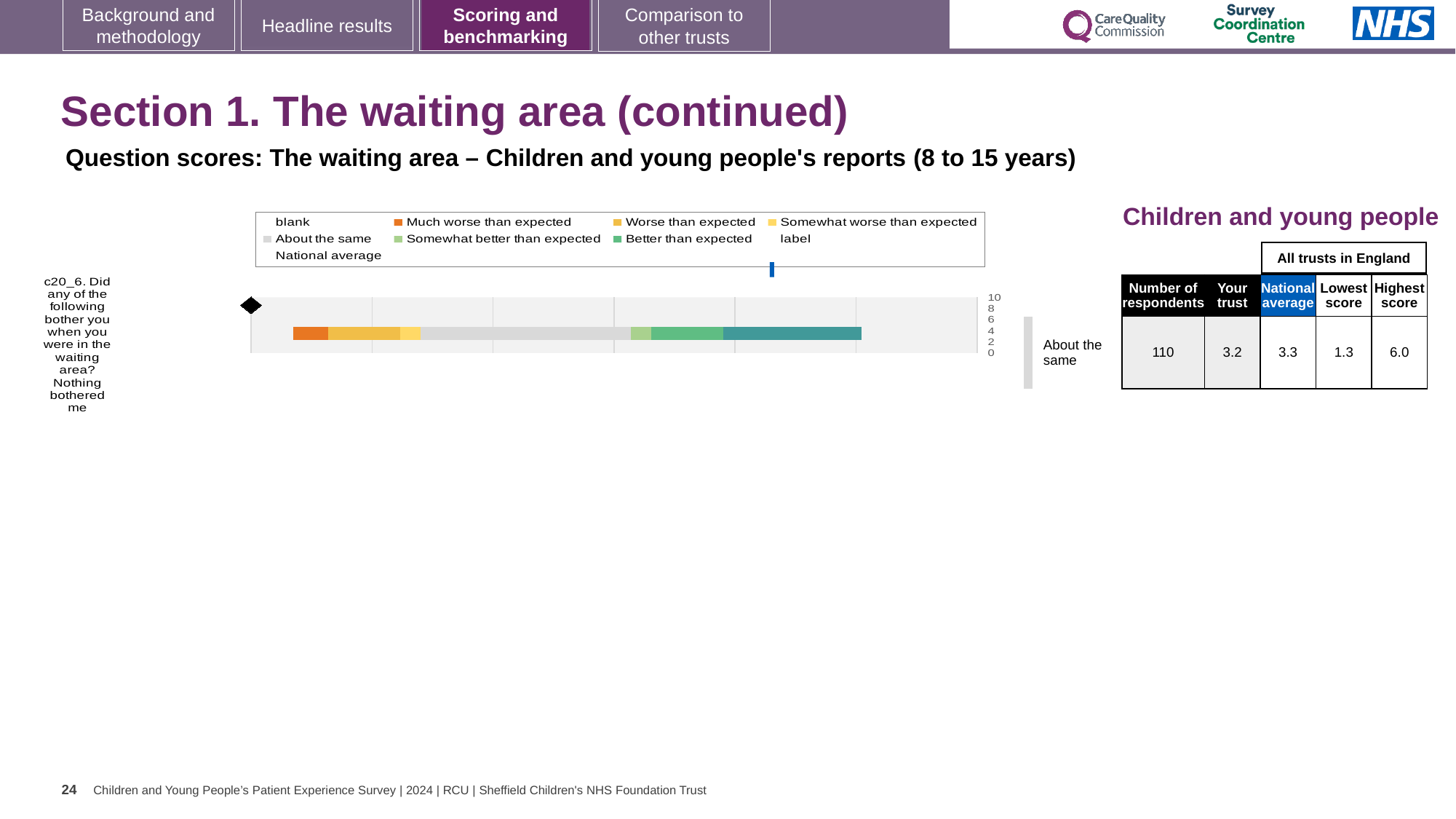
In the table next to the chart, what is the number of respondents? 110 What colour represents 'Much worse than expected' in the chart legend? orange What rating label is shown next to the bar for question c20_6? About the same In the table next to the chart, what is the lowest score among all trusts in England? 1.3 Which question code is plotted in the chart? c20_6 How many entries does the chart legend list? 9 In the table next to the chart, what is the highest score among all trusts in England? 6.0 In the table next to the chart, which is larger: the 'Your trust' score or the national average? national average How many question categories are plotted in the chart? 1 In the table next to the chart, what is the national average score? 3.3 In the table next to the chart, what is the 'Your trust' score for question c20_6? 3.2 What kind of chart is shown on the slide? bar chart